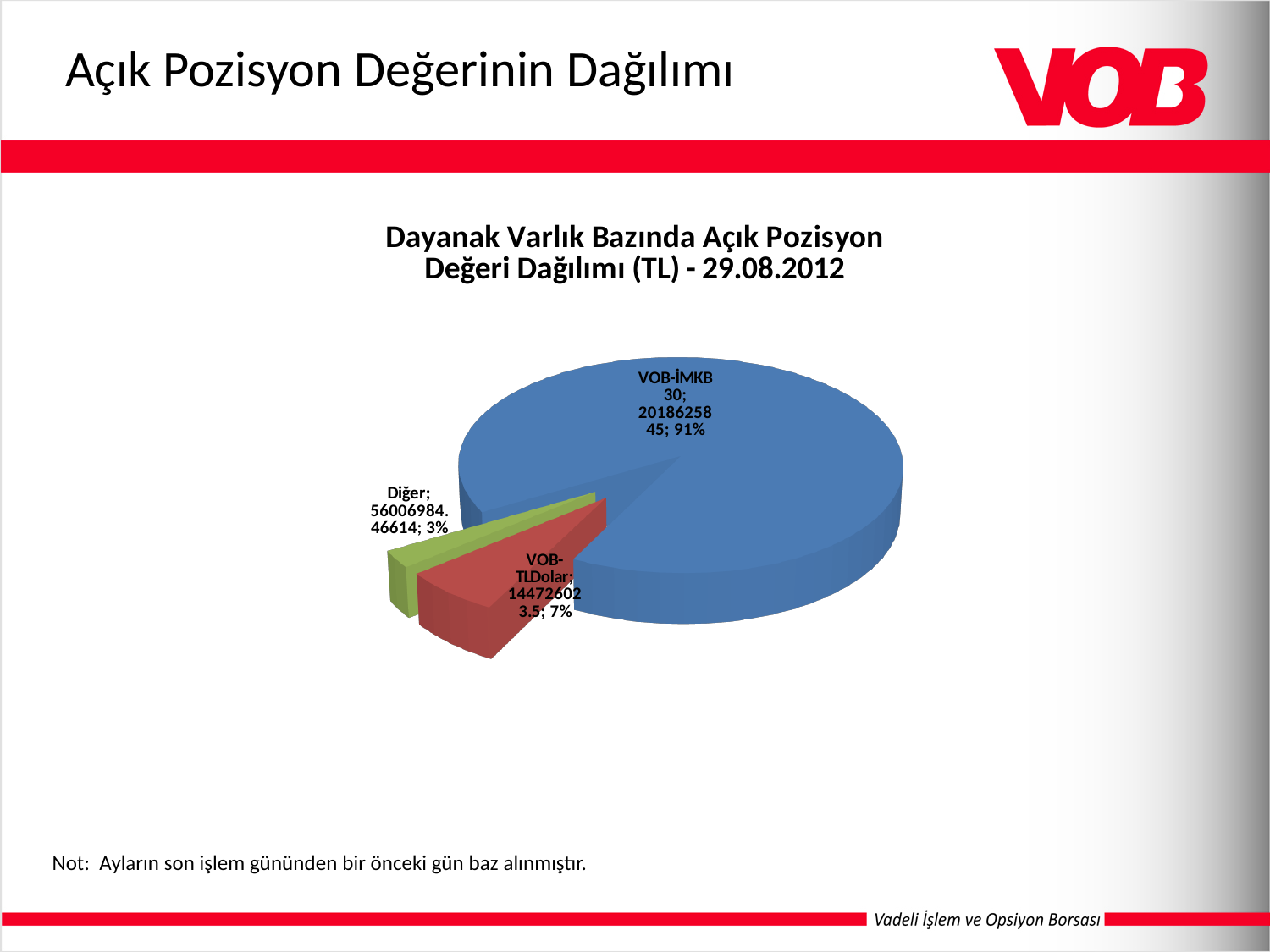
What percentage share does VOB-TLDolar have in the pie chart? 7% What percentage share does Diğer have in the pie chart? 3% What value (TL) is shown for VOB-TLDolar in the pie chart? 144726023.5 How many slices does the pie chart have? 3 Which is larger, the slice for VOB-TLDolar or the slice for Diğer? VOB-TLDolar Which category has the largest slice of the pie chart? VOB-İMKB 30 What percentage share does VOB-İMKB 30 have in the pie chart? 91% What value (TL) is shown for Diğer in the pie chart? 56006984.46614 What is the title of the pie chart? Dayanak Varlık Bazında Açık Pozisyon Değeri Dağılımı (TL) - 29.08.2012 Which category has the smallest slice of the pie chart? Diğer What colour is the VOB-İMKB 30 slice in the pie chart? Blue What kind of chart is shown on the slide? Pie chart